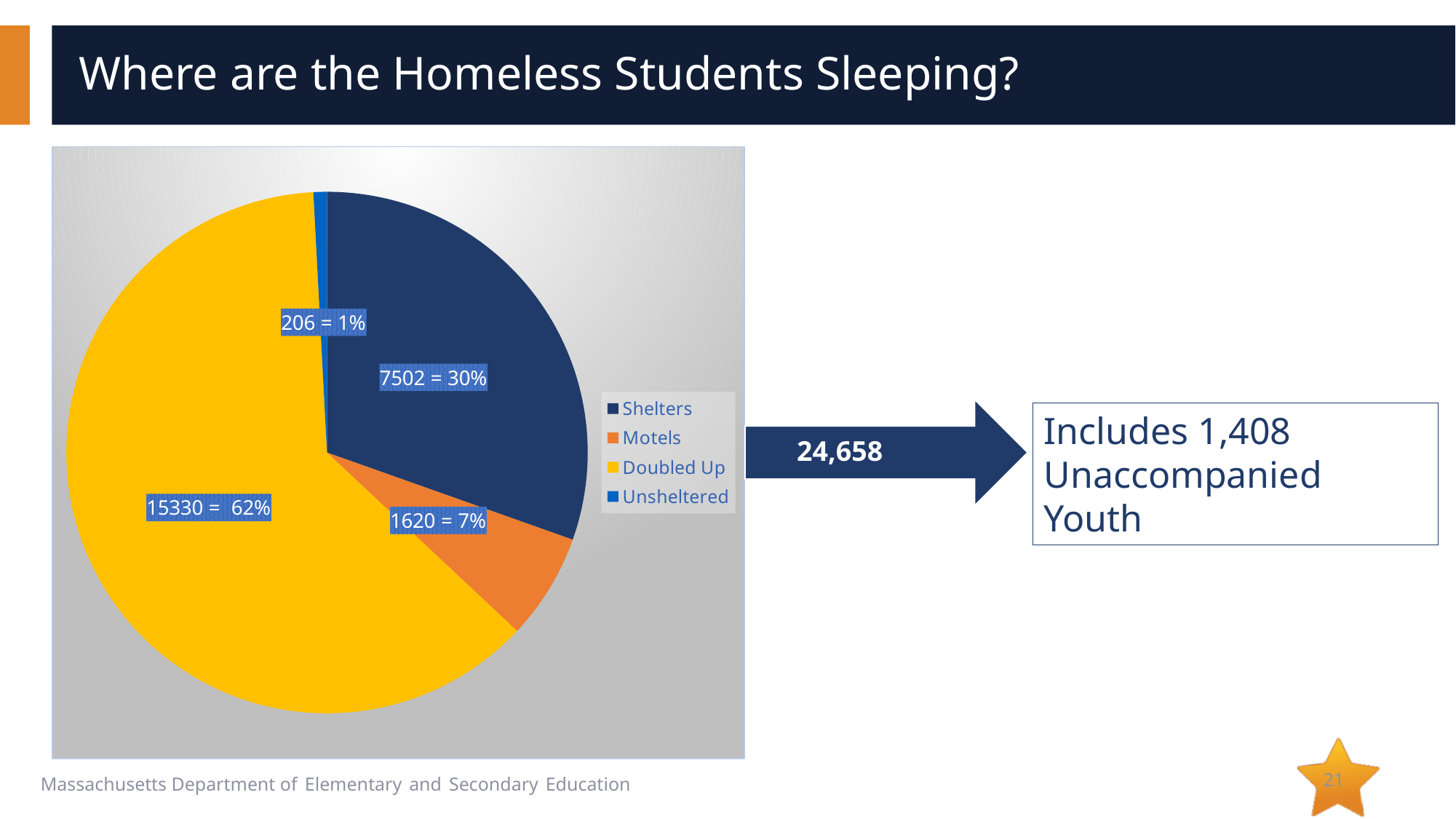
What is the value for Doubled Up? 15330 What is the value for Shelters? 7502 Which category has the smallest slice? Unsheltered What share of the pie does Doubled Up represent? 62% What share of the pie does Motels represent? 7% What is the difference between the values for Doubled Up and Shelters? 7828 What kind of chart is shown on the slide? pie chart Which category has the largest slice? Doubled Up How many categories does the pie chart show? 4 Which is larger, the value for Shelters or the value for Motels? Shelters What is the value for Motels? 1620 What is the value for Unsheltered? 206